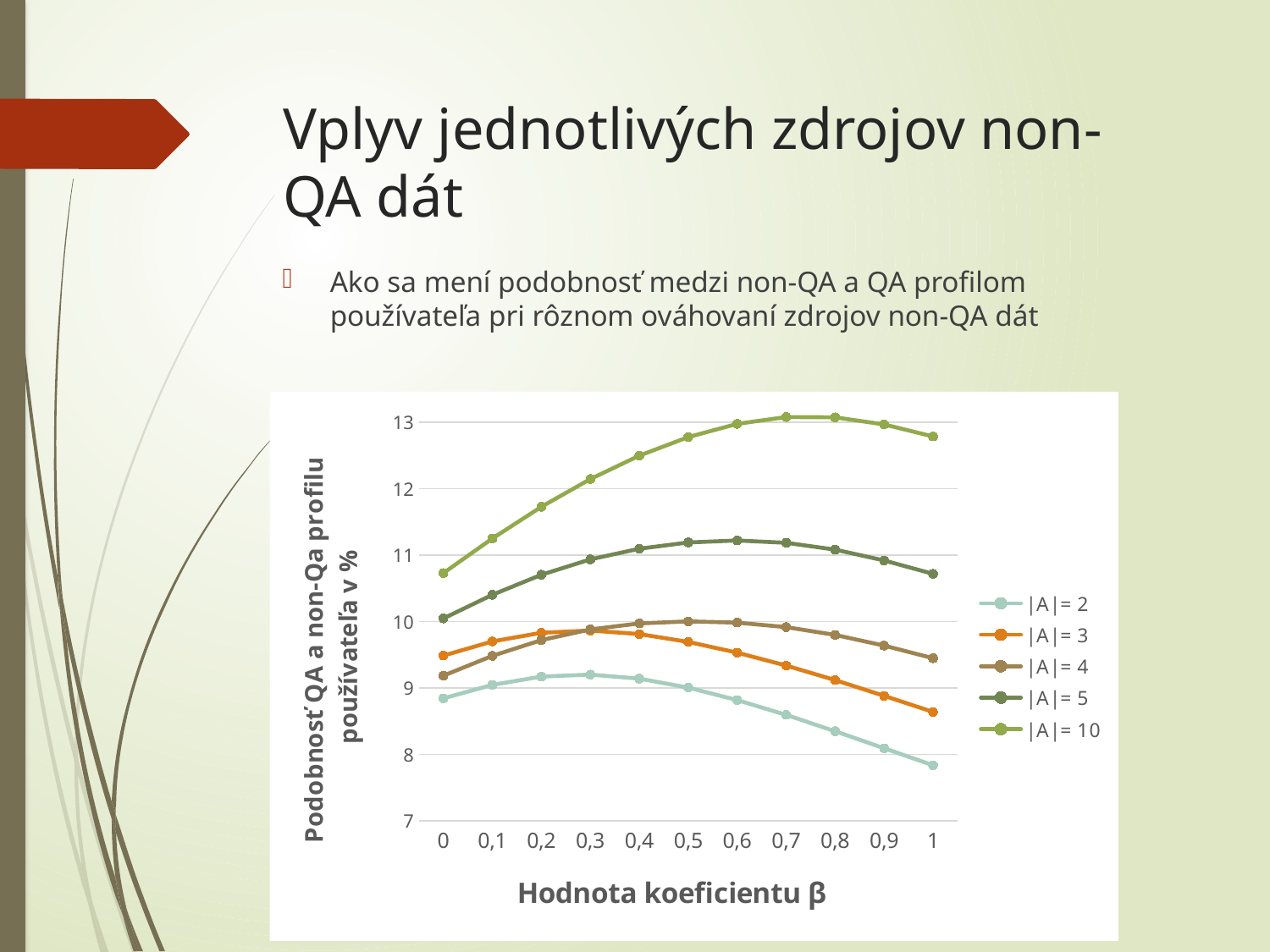
How many values of β are plotted along the x axis? 11 What kind of chart is shown on the slide? line chart How many series does the legend list? 5 Does the |A|= 2 series rise or fall between β = 0.4 and β = 1? fall Is the value for |A|= 2 at β = 1 greater or less than 8? less Is the value for |A|= 5 at β = 0.5 greater or less than 11? greater Is the value for |A|= 10 at β = 0 greater or less than 10? greater Which series has the highest similarity values across the chart? |A|= 10 At β = 0, which series has the larger value, |A|= 3 or |A|= 4? |A|= 3 What is the title of the x axis? Hodnota koeficientu β Which series has the lowest similarity values across the chart? |A|= 2